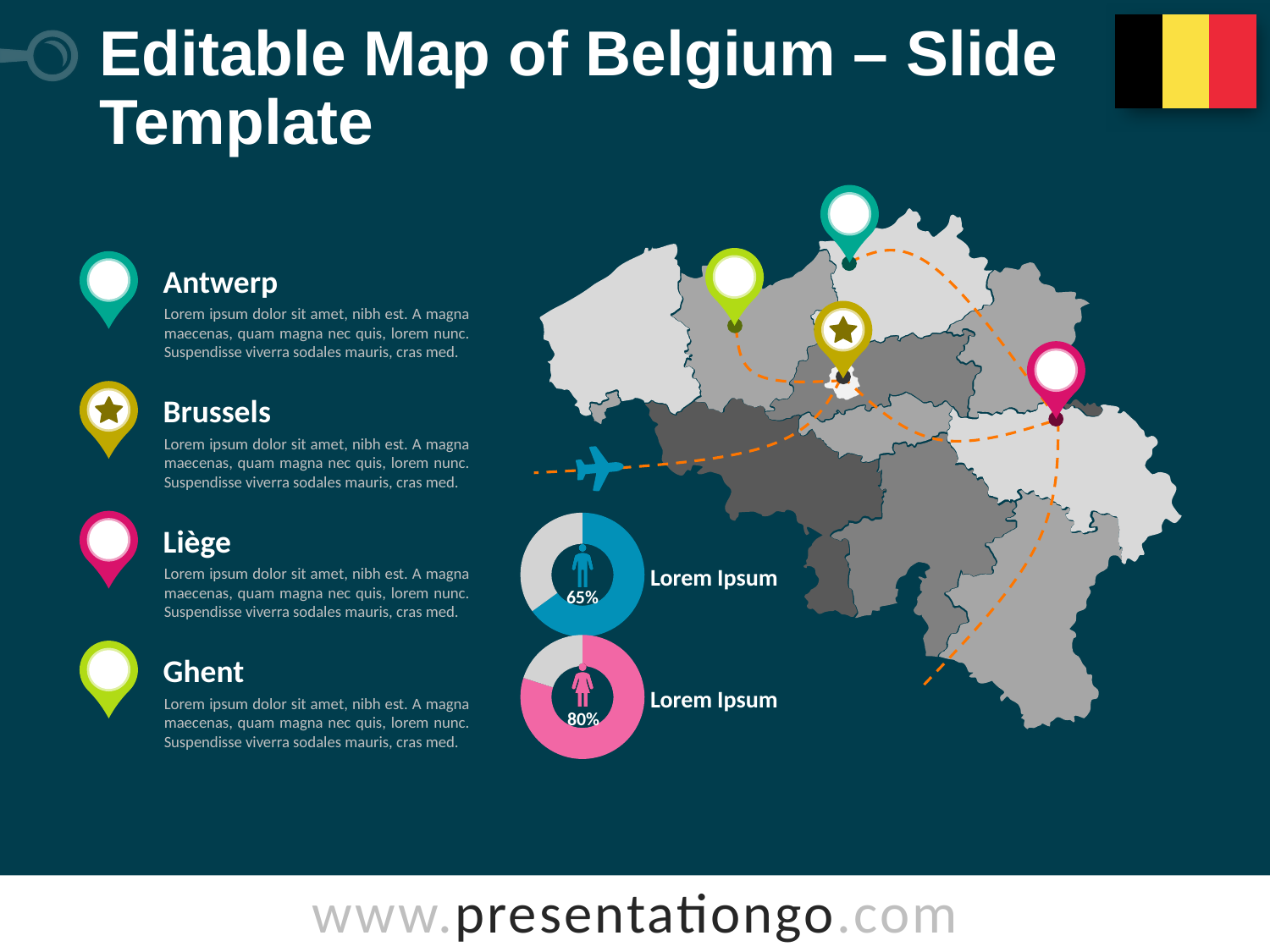
What colour is the filled portion of the lower donut chart? Pink What kind of charts are shown below the map on the slide? Donut charts Is the value in the lower (pink) donut chart greater or less than 75%? greater What is the difference between the percentage in the lower (pink) donut chart and the upper (blue) donut chart? 15% Which donut chart shows the larger percentage, the upper blue one or the lower pink one? The lower pink one How many donut charts are on the slide? 2 Which donut chart shows the lowest percentage? The upper blue one (65%) Is the value in the upper (blue) donut chart greater or less than 50%? greater What percentage is shown in the lower (pink) donut chart? 80% What label text appears to the right of each donut chart? Lorem Ipsum What share of the upper (blue) donut chart is left unfilled (grey)? 35% What percentage is shown in the upper (blue) donut chart? 65%